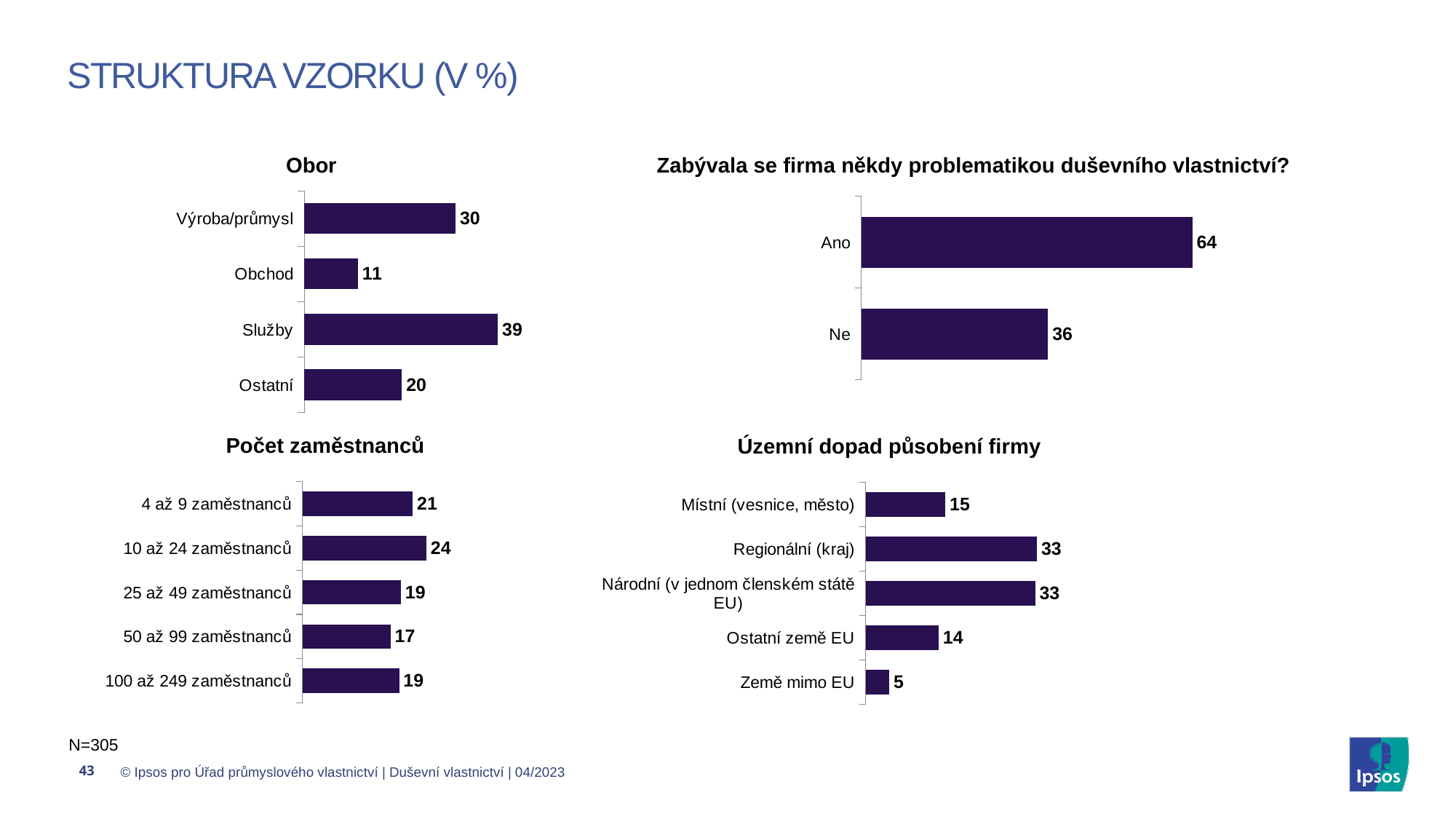
In the 'Zabývala se firma někdy problematikou duševního vlastnictví?' chart, how many categories are shown? 2 What type of chart is the 'Územní dopad působení firmy' chart? Bar chart In the 'Zabývala se firma někdy problematikou duševního vlastnictví?' chart, what is the value for Ano? 64 In the 'Obor' chart, what is the difference between Výroba/průmysl and Ostatní? 10 In the 'Počet zaměstnanců' chart, which category has the highest value? 10 až 24 zaměstnanců In the 'Počet zaměstnanců' chart, what is the value for 50 až 99 zaměstnanců? 17 In the 'Územní dopad působení firmy' chart, which category has the lowest value? Země mimo EU In the 'Obor' chart, which category has the lowest value? Obchod In the 'Počet zaměstnanců' chart, how many categories are shown? 5 In the 'Zabývala se firma někdy problematikou duševního vlastnictví?' chart, what is the difference between Ano and Ne? 28 In the 'Obor' chart, what is the value for Služby? 39 In the 'Územní dopad působení firmy' chart, which is larger: Místní (vesnice, město) or Ostatní země EU? Místní (vesnice, město)